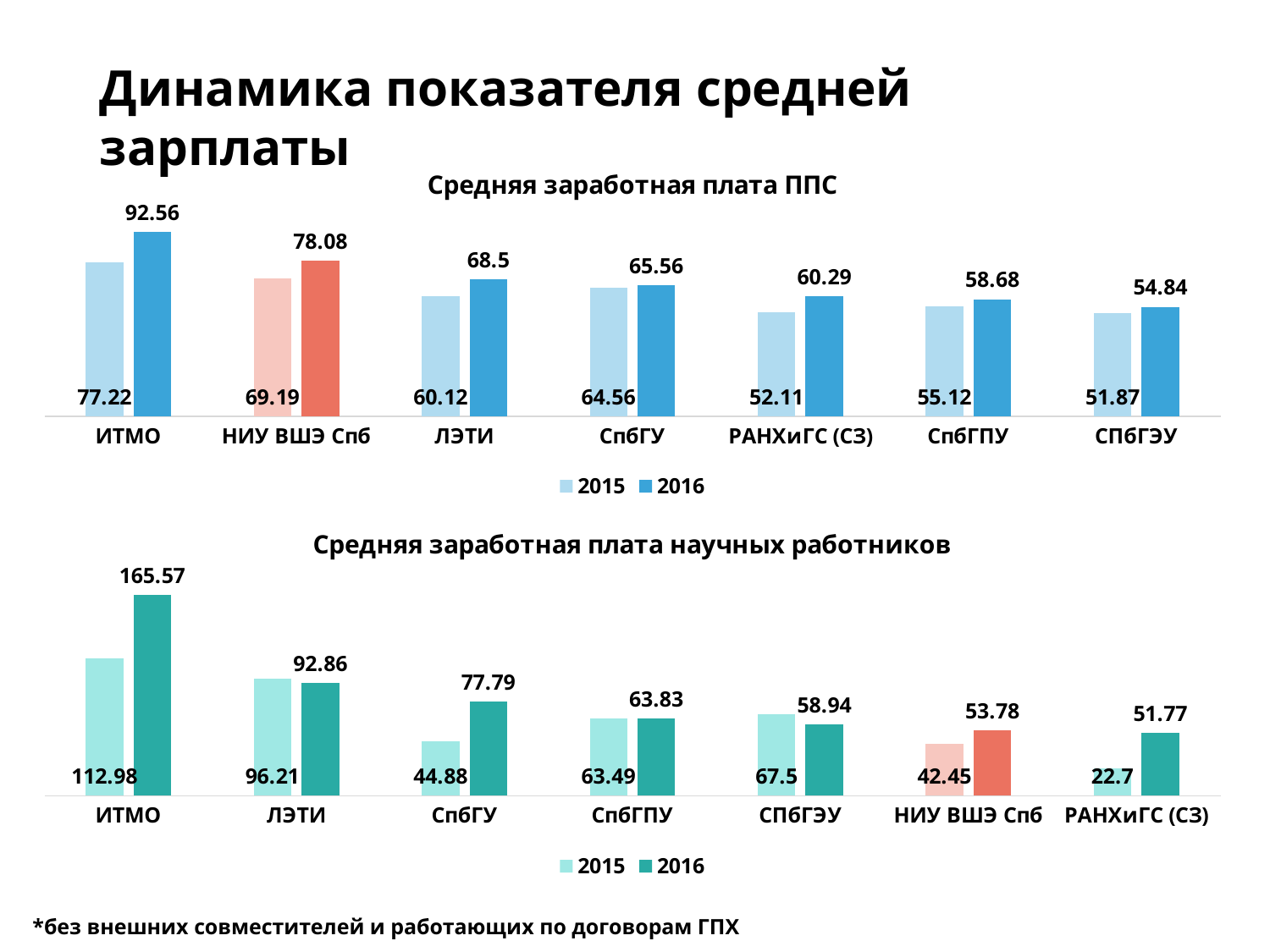
What type of chart is 'Средняя заработная плата ППС'? Bar chart In the chart 'Средняя заработная плата ППС', what is the 2016 value for ИТМО? 92.56 In the chart 'Средняя заработная плата научных работников', what is the 2016 value for СПбГУ? 77.79 In the chart 'Средняя заработная плата научных работников', what is the 2015 value for РАНХиГС (СЗ)? 22.7 How many series does the legend of the chart 'Средняя заработная плата научных работников' list? 2 In the chart 'Средняя заработная плата научных работников', which is larger for ЛЭТИ: the 2015 value or the 2016 value? 2015 In the chart 'Средняя заработная плата научных работников', which category has the highest 2016 value? ИТМО In the chart 'Средняя заработная плата ППС', how many categories are shown on the x axis? 7 In the chart 'Средняя заработная плата научных работников', what is the difference between the 2016 and 2015 values for ИТМО? 52.59 In the chart 'Средняя заработная плата ППС', which category has the lowest 2016 value? СПбГЭУ In the chart 'Средняя заработная плата ППС', what is the 2015 value for РАНХиГС (СЗ)? 52.11 In the chart 'Средняя заработная плата ППС', what is the difference between the 2016 and 2015 values for ЛЭТИ? 8.38